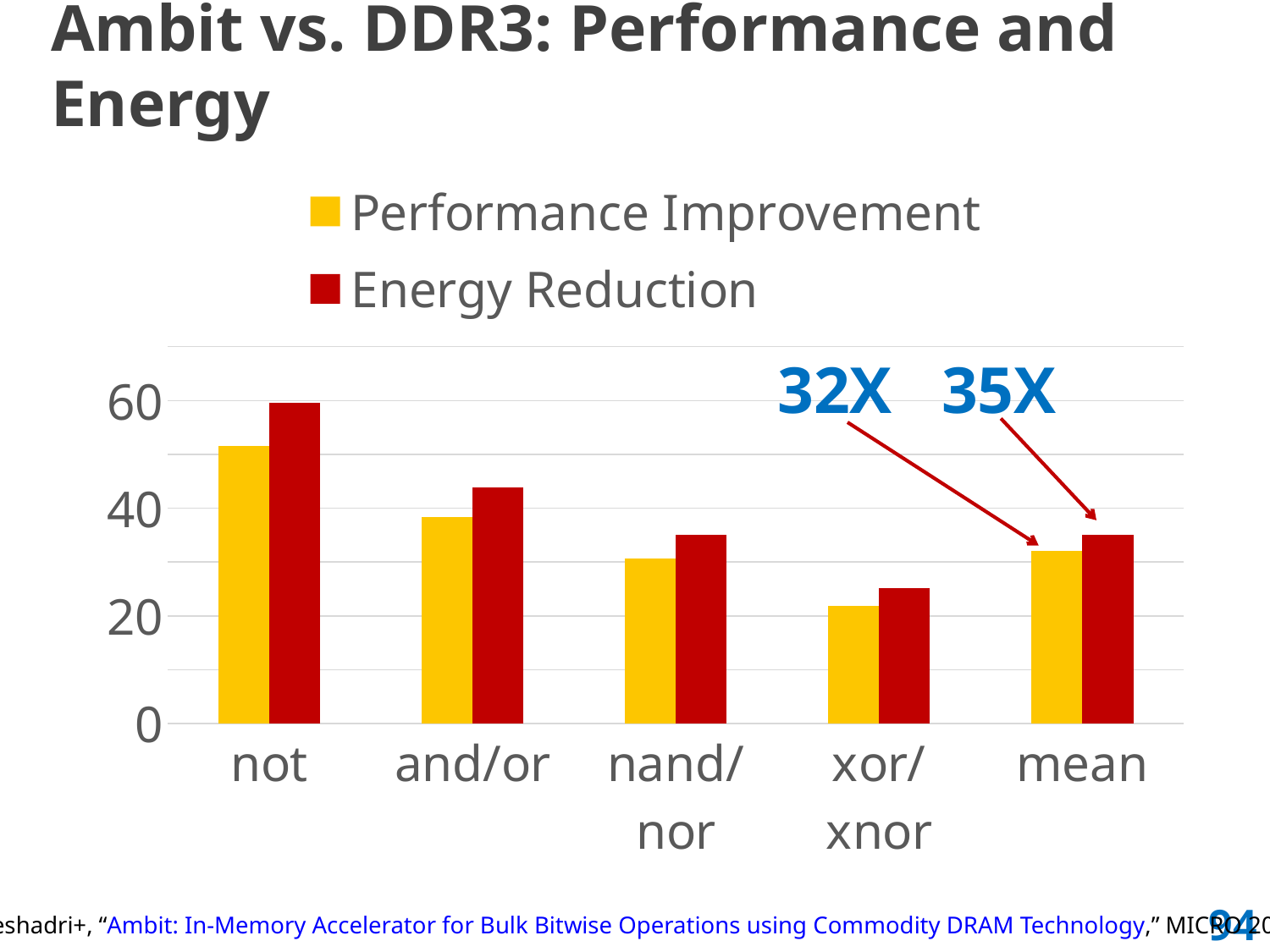
What kind of chart is shown on the slide? bar chart What is the mean Energy Reduction shown on the chart? 35X Which operation has the highest Performance Improvement? not Do the Performance Improvement values rise or fall from 'not' to 'xor/xnor'? fall What is the mean Performance Improvement shown on the chart? 32X What is the difference between the mean Energy Reduction and the mean Performance Improvement? 3X Is the Performance Improvement for 'xor/xnor' greater or less than 40? less Is the Energy Reduction for 'not' greater or less than 40? greater How many categories are shown on the x axis? 5 For the 'not' operation, which is larger: Performance Improvement or Energy Reduction? Energy Reduction Which operation has the lowest Energy Reduction? xor/xnor How many series does the legend list? 2